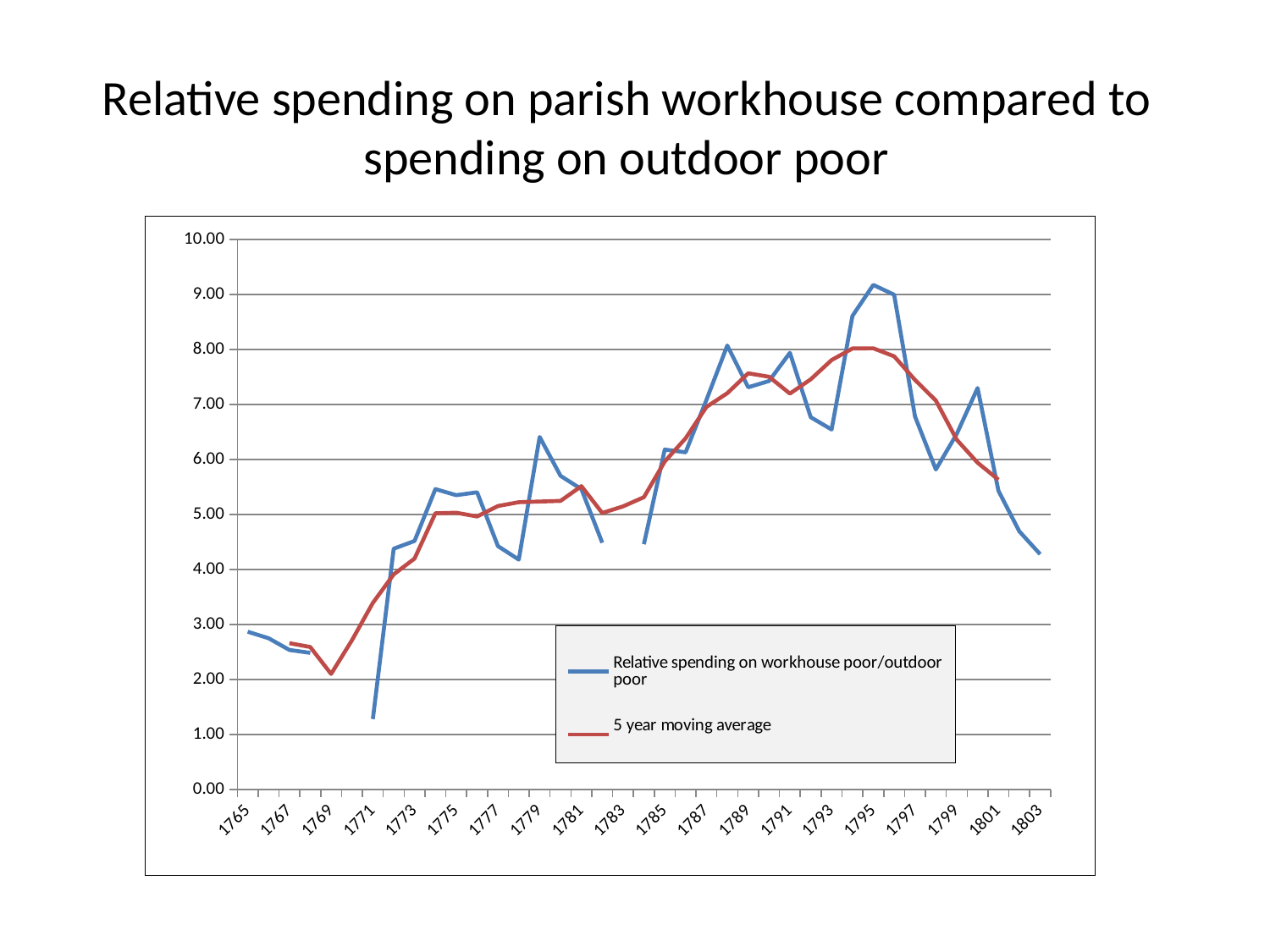
Is the value of the blue line for 1795 greater or less than 9.00? greater Does the 5 year moving average rise or fall between 1795 and 1801? fall What is the title of the chart on the slide? Relative spending on parish workhouse compared to spending on outdoor poor What is the name of the series drawn in red? 5 year moving average What kind of chart is shown on the slide? line chart Is the value of the 5 year moving average for 1795 greater or less than 7.00? greater In which year does the blue 'Relative spending on workhouse poor/outdoor poor' line reach its lowest value? 1771 In which year does the blue 'Relative spending on workhouse poor/outdoor poor' line reach its highest value? 1795 How many series does the legend list? 2 Which is larger for the blue line: the value for 1765 or the value for 1787? 1787 Is the value of the blue line for 1803 greater or less than 5.00? less